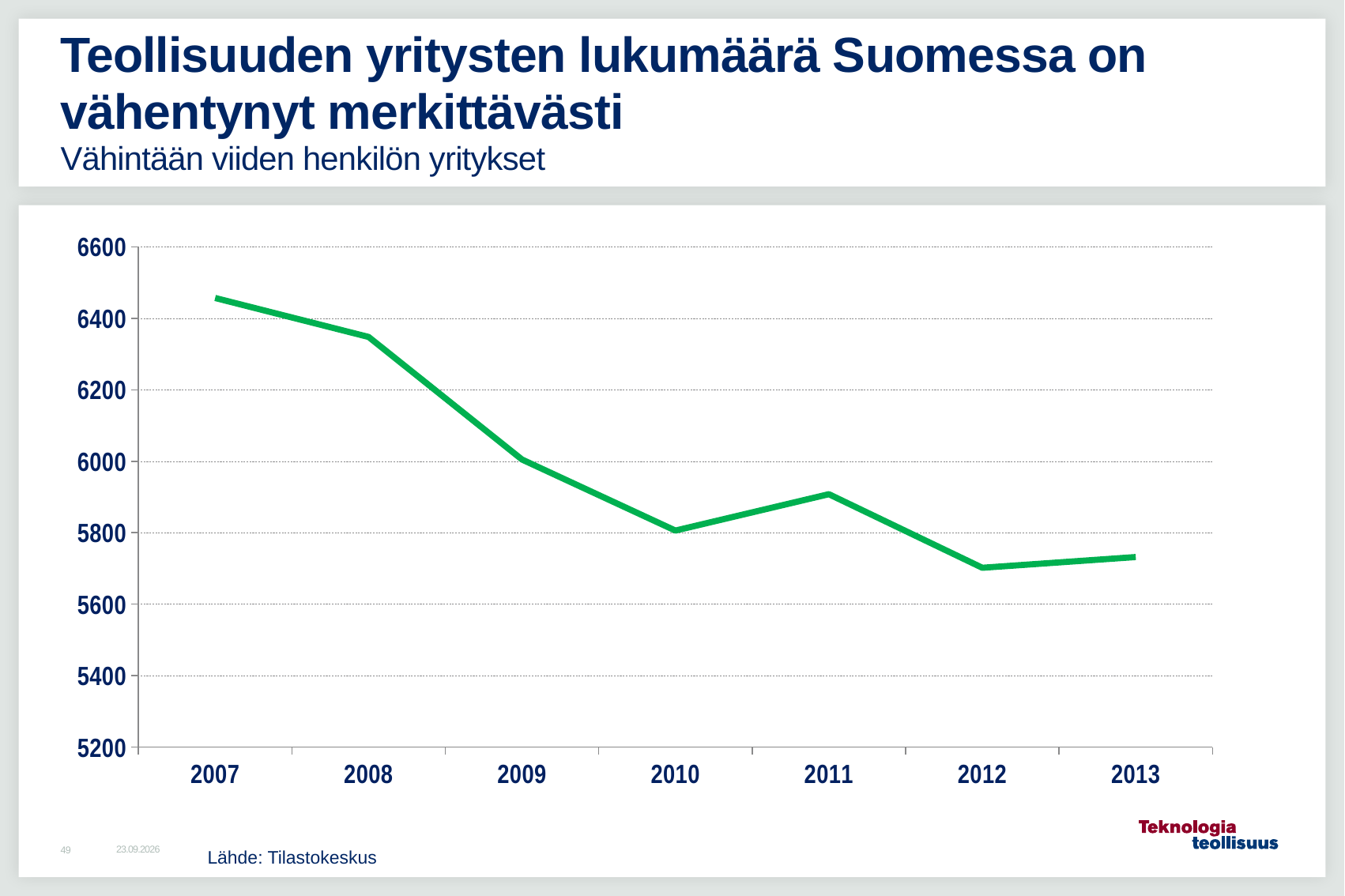
How many years are plotted on the x axis? 7 Which is larger, the value for 2010 or the value for 2011? 2011 Is the value for 2008 greater or less than 6400? less Is the value for 2010 greater or less than 6000? less Is the value for 2007 greater or less than 6400? greater What source is cited for the chart data? Tilastokeskus What kind of chart is shown on the slide? line chart Which year has the lowest value? 2012 Do the values generally rise or fall from 2007 to 2013? fall Which year has the highest value? 2007